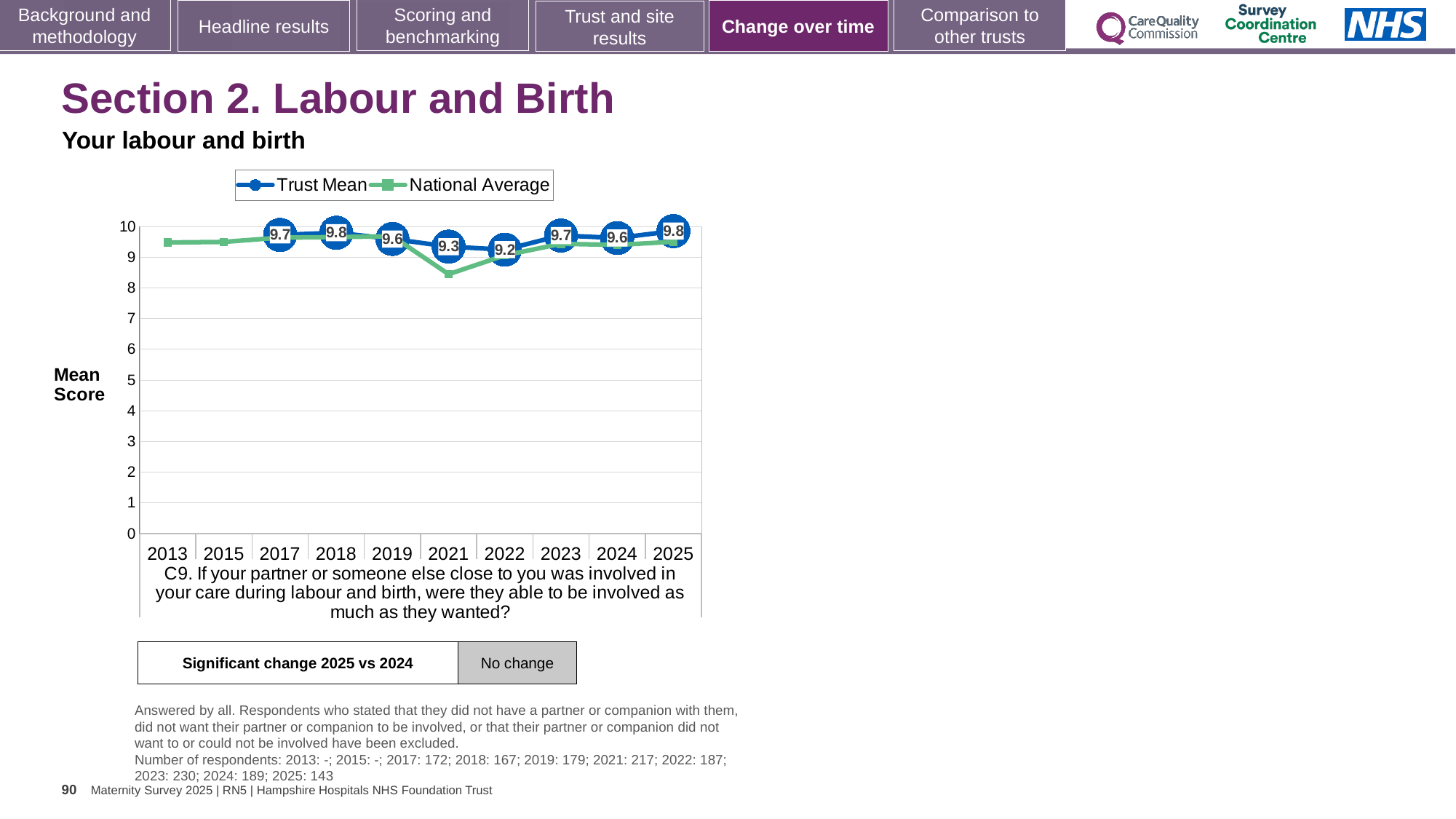
How many years are shown on the x axis of the chart? 10 What kind of chart is shown on the slide? line chart What is the Trust Mean score for 2019? 9.6 How many series does the legend list? 2 Which year has the higher Trust Mean score, 2021 or 2022? 2021 In which year is the Trust Mean score lowest? 2022 What is the Trust Mean score for 2021? 9.3 What is the Trust Mean score for 2025? 9.8 What is the difference between the Trust Mean scores for 2025 and 2024? 0.2 Does the Trust Mean score rise or fall from 2018 to 2022? fall Is the National Average value for 2021 greater or less than 9? less What does the box labelled 'Significant change 2025 vs 2024' say? No change